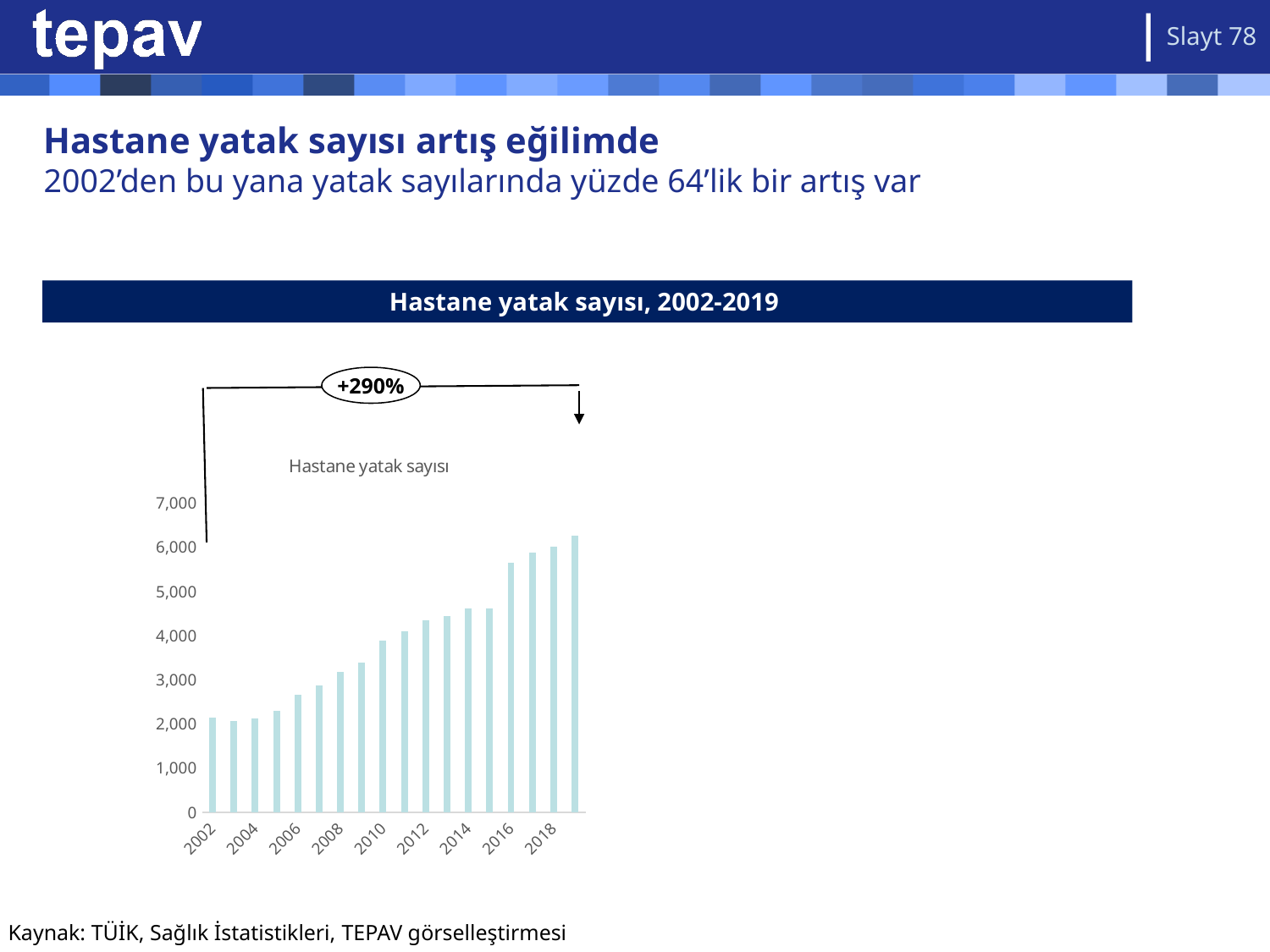
Which year has the highest number of hospital beds? 2019 Is the value for 2019 greater or less than 6,000? greater Is the value for 2002 greater or less than 2,000? greater Which year has a larger value, 2012 or 2006? 2012 Is the value for 2016 greater or less than 5,000? greater What percentage change is shown in the annotation above the chart? +290% How many years (bars) are plotted in the chart? 18 What is the title shown in the dark banner above the chart? Hastane yatak sayısı, 2002-2019 What kind of chart is shown on the slide? bar chart Do the hospital bed values generally rise or fall from 2002 to 2019? rise